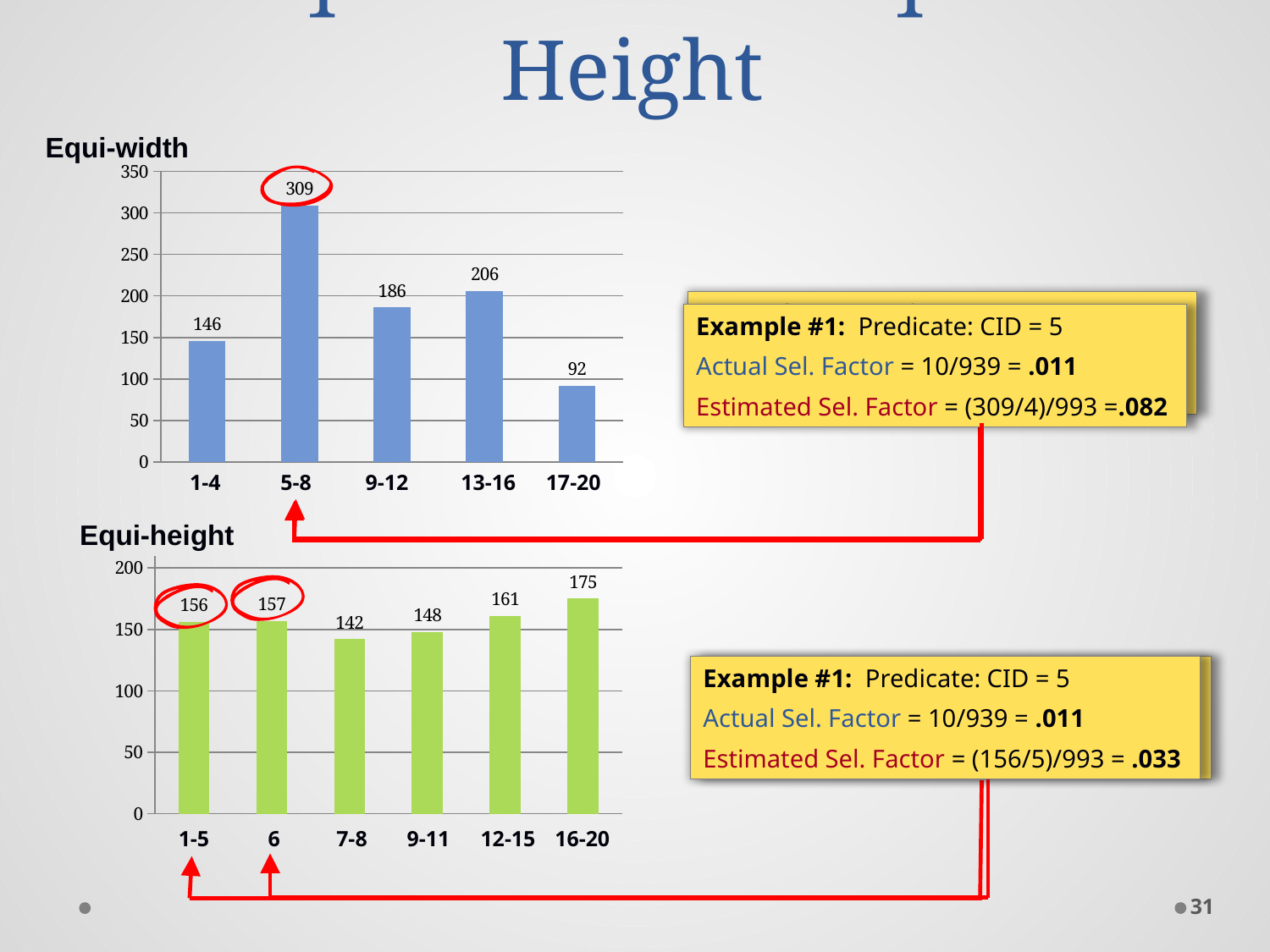
In the Equi-height chart, what is the difference between the values for 16-20 and 1-5? 19 In the Equi-width chart, which category has the lowest value? 17-20 In the Equi-width chart, is the value for 1-4 greater or less than 100? greater In the Equi-width chart, what is the difference between the values for 13-16 and 9-12? 20 In the Equi-height chart, which category has the highest value? 16-20 In the Equi-width chart, how many categories are shown on the x axis? 5 In the Equi-height chart, what is the value for the 7-8 category? 142 In the Equi-height chart, which is larger, the value for 12-15 or the value for 9-11? 12-15 In the Equi-width chart, what is the value for the 5-8 category? 309 What kind of chart is the Equi-width chart? Bar chart In the Equi-height chart, which category has the lowest value? 7-8 In the Equi-height chart, how many categories are shown on the x axis? 6